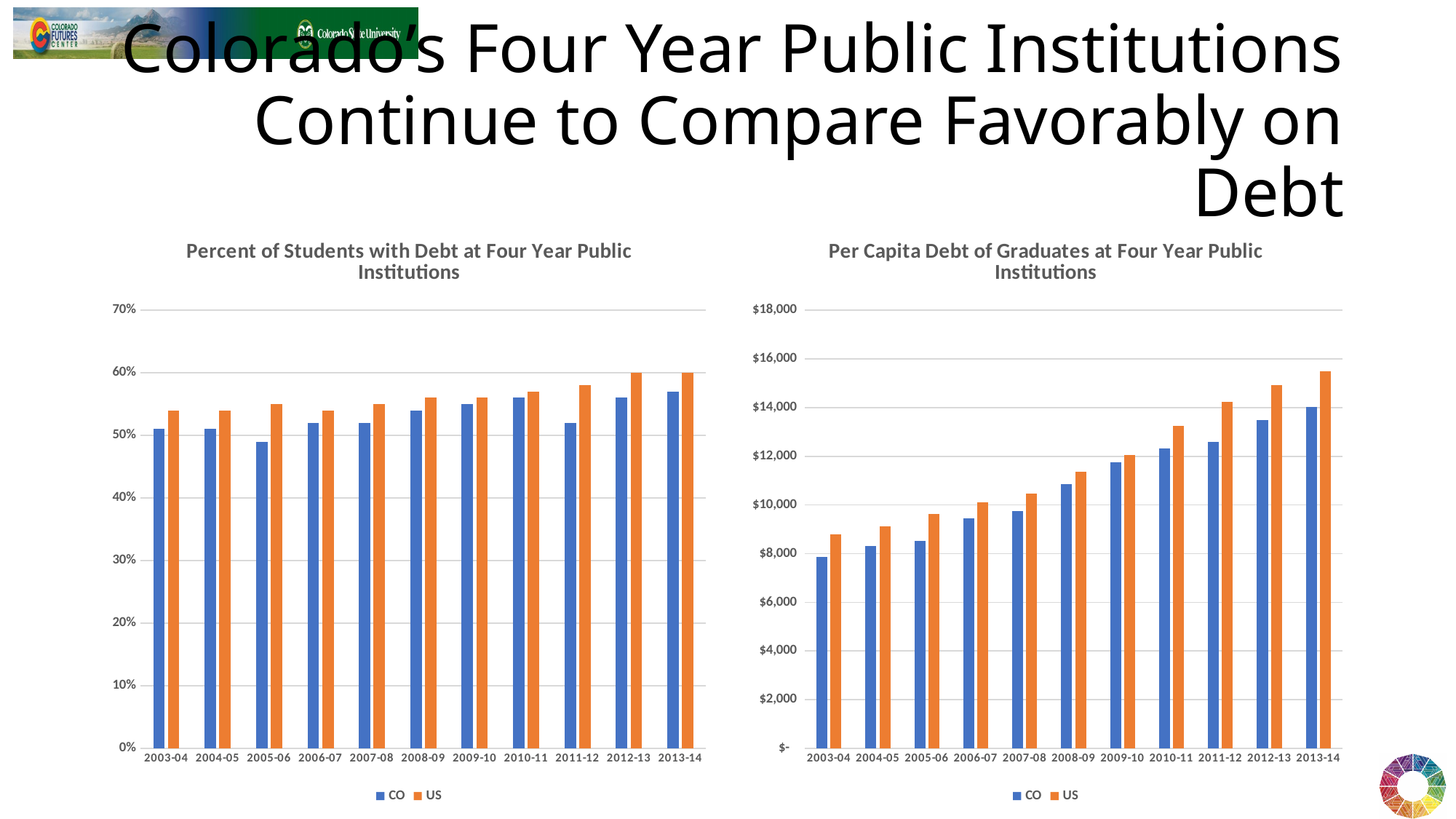
In the right chart, 'Per Capita Debt of Graduates at Four Year Public Institutions', which is larger for 2013-14, CO or US? US In the right chart, 'Per Capita Debt of Graduates at Four Year Public Institutions', which year has the highest US value? 2013-14 In the left chart, 'Percent of Students with Debt at Four Year Public Institutions', which is larger for 2011-12, CO or US? US In the right chart, 'Per Capita Debt of Graduates at Four Year Public Institutions', which year has the lowest CO value? 2003-04 What type of chart is the left chart, 'Percent of Students with Debt at Four Year Public Institutions'? bar chart In the left chart, 'Percent of Students with Debt at Four Year Public Institutions', is the CO value for 2005-06 greater or less than 50%? less In the left chart, 'Percent of Students with Debt at Four Year Public Institutions', which colour represents the US series? orange How many series does the legend list on the right chart, 'Per Capita Debt of Graduates at Four Year Public Institutions'? 2 In the right chart, 'Per Capita Debt of Graduates at Four Year Public Institutions', is the US value for 2010-11 greater or less than $12,000? greater How many academic years are shown on the x axis of the left chart, 'Percent of Students with Debt at Four Year Public Institutions'? 11 In the right chart, 'Per Capita Debt of Graduates at Four Year Public Institutions', do the US values generally rise or fall from 2003-04 to 2013-14? rise